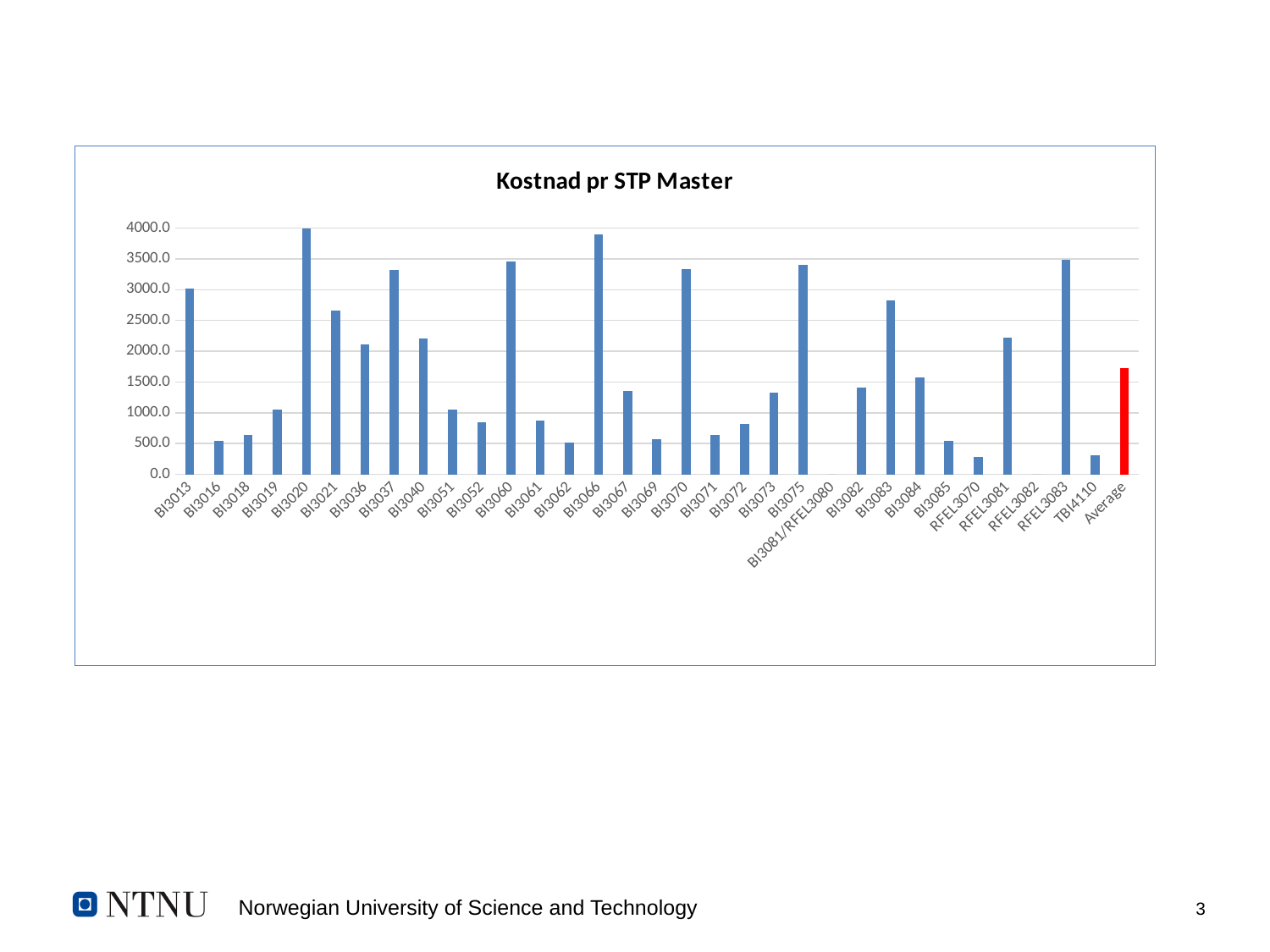
Is the value for BI3083 greater or less than 2500? greater Which is larger, the value for BI3020 or the value for BI3016? BI3020 Is the value for BI3067 greater or less than 1500? less What kind of chart is shown on the slide? bar chart Is the value for TBI4110 greater or less than 500? less Which is larger, the value for BI3083 or the value for BI3084? BI3083 Which is larger, the value for BI3075 or the value for BI3073? BI3075 What is the title of the chart? Kostnad pr STP Master Which bar is coloured red rather than blue? Average